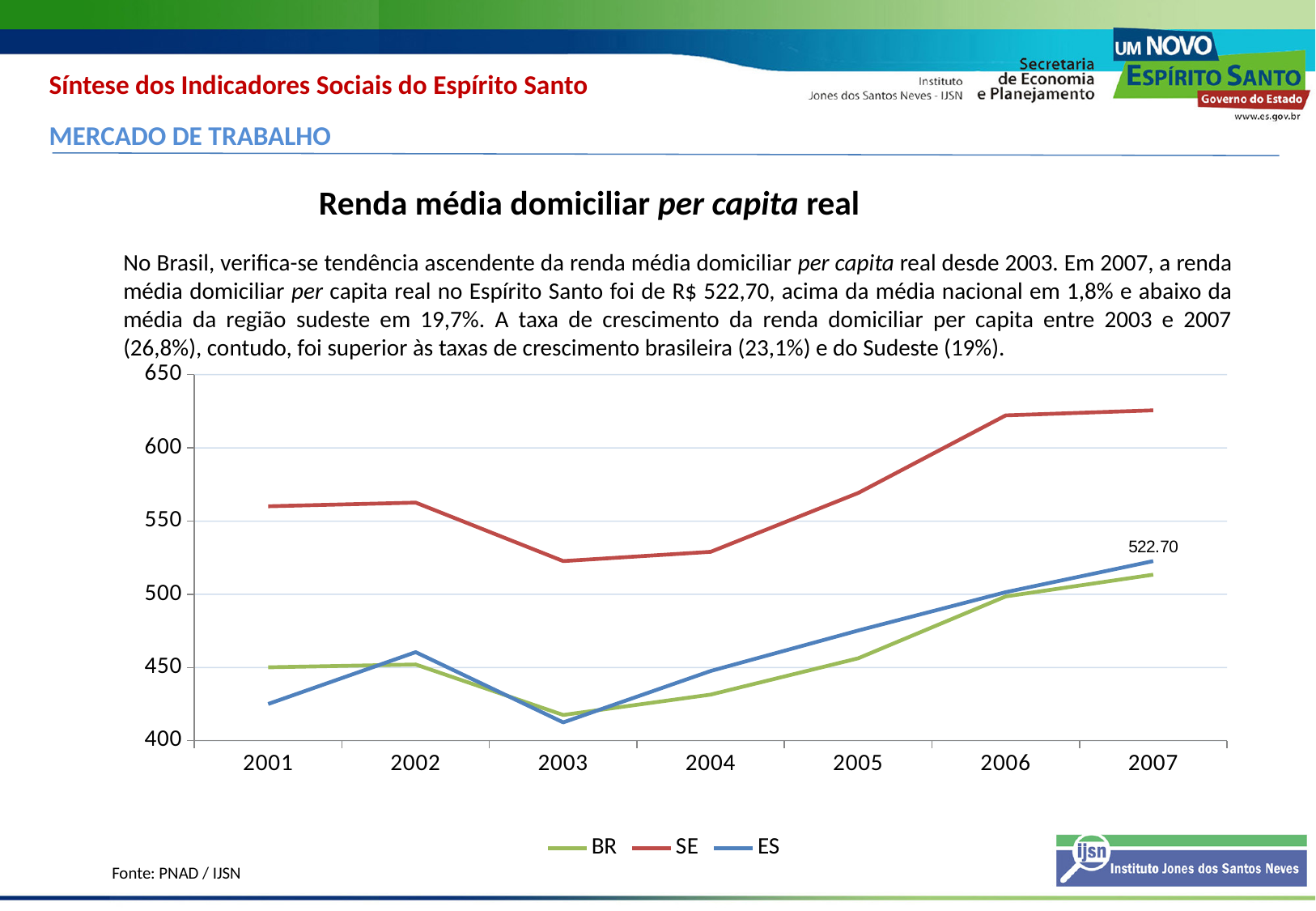
In which year does the SE series reach its lowest value? 2003 Which series has the highest value in 2007? SE Is the value for BR in 2001 greater or less than 500? less Is the value for ES in 2003 greater or less than 450? less Does the SE series rise or fall from 2003 to 2007? rise How many series does the legend list? 3 What kind of chart is shown on the slide? line chart What is the value for ES in 2007? 522.70 Is the value for SE in 2007 greater or less than 600? greater In which year does the ES series reach its lowest value? 2003 In 2001, which series has the larger value, BR or ES? BR How many years are shown on the x axis? 7